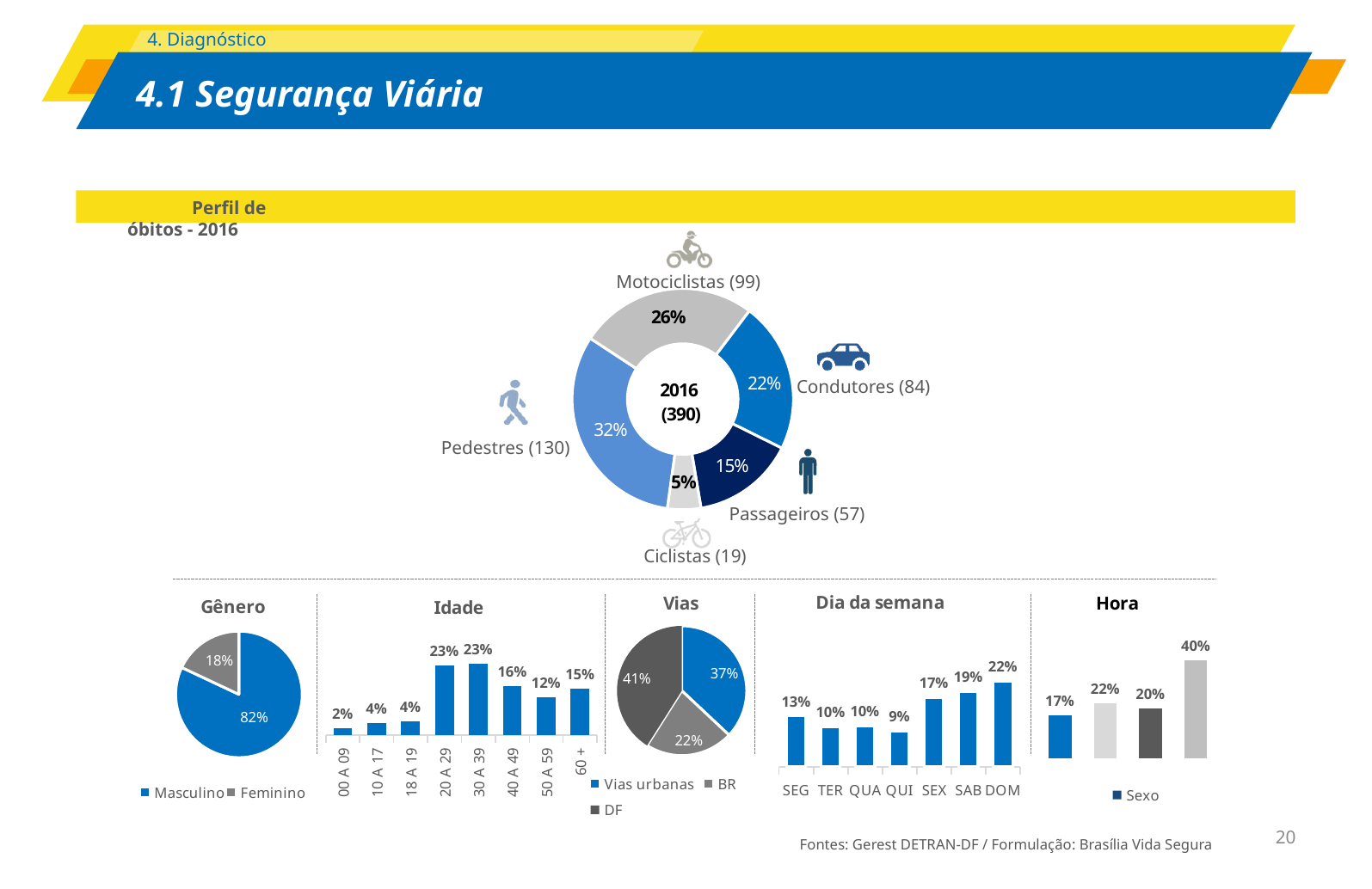
In the 'Idade' bar chart, which age group has the lowest value? 00 A 09 In the 'Idade' bar chart, how many age groups are shown? 8 In the donut chart 'Perfil de óbitos - 2016', what is the total number of deaths shown in the centre? 390 In the donut chart 'Perfil de óbitos - 2016', how many more percentage points do Motociclistas have than Passageiros? 11% In the 'Dia da semana' bar chart, which day has the highest value? DOM In the 'Dia da semana' bar chart, what is the difference between SAB and QUI? 10% In the 'Idade' bar chart, what is the value for the 40 A 49 age group? 16% In the donut chart 'Perfil de óbitos - 2016', what percentage of deaths were Pedestres? 32% In the 'Gênero' pie chart, what is the share for Masculino? 82% In the 'Vias' pie chart, which category has the largest share? DF In the donut chart 'Perfil de óbitos - 2016', which category has the smallest share? Ciclistas In the 'Hora' bar chart, what is the highest value shown? 40%